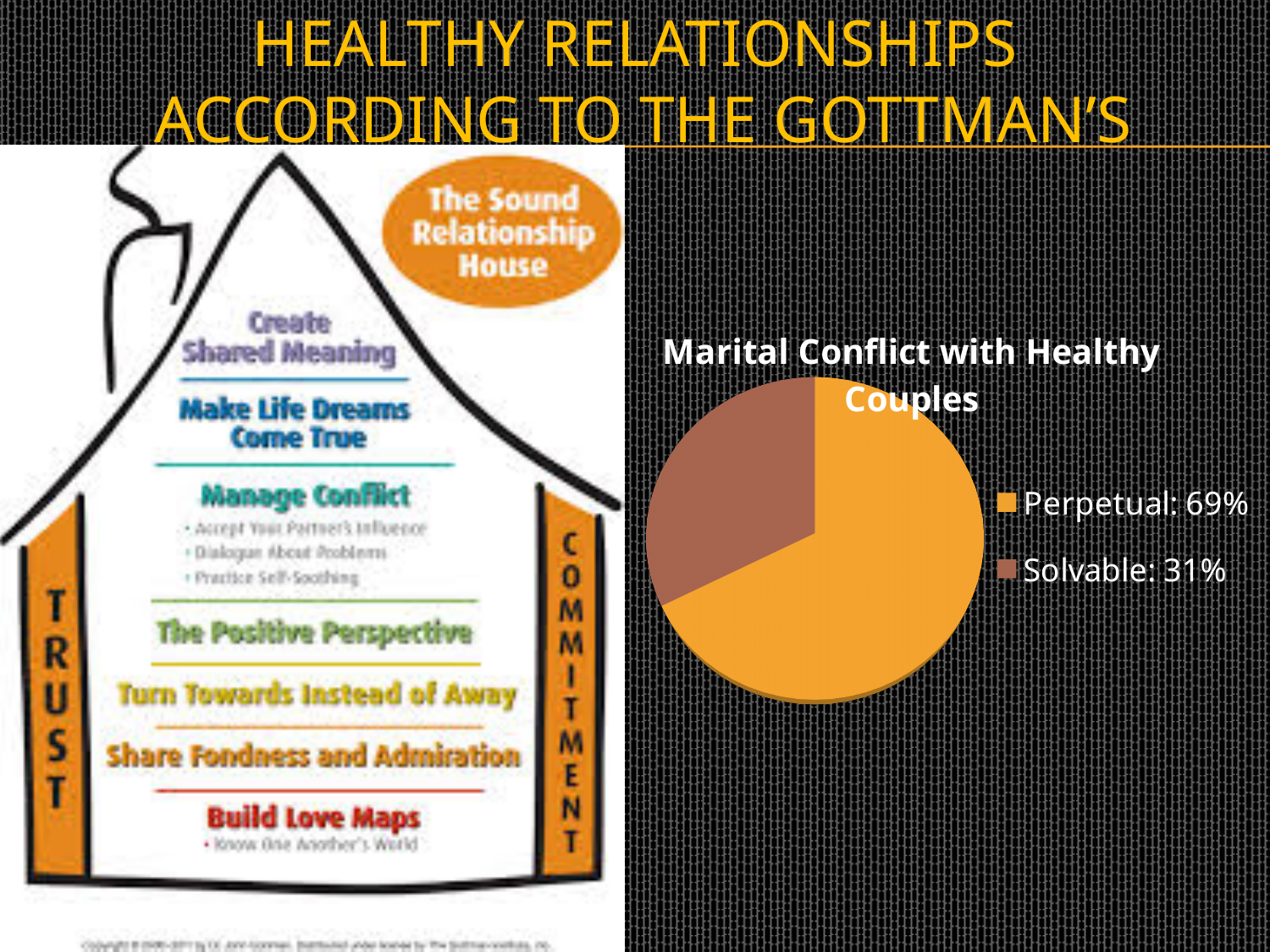
Which slice of the pie chart is the smallest? Solvable What share of the pie is Solvable? 31% What kind of chart is shown on the slide? pie chart What is the difference between the Perpetual and Solvable shares? 38% Which slice of the pie chart is the largest? Perpetual What colour is the Perpetual slice of the pie chart? orange How many entries does the legend of the pie chart list? 2 What is the title of the pie chart? Marital Conflict with Healthy Couples What share of the pie is Perpetual? 69% Which is larger, the Perpetual share or the Solvable share? Perpetual How many slices does the pie chart have? 2